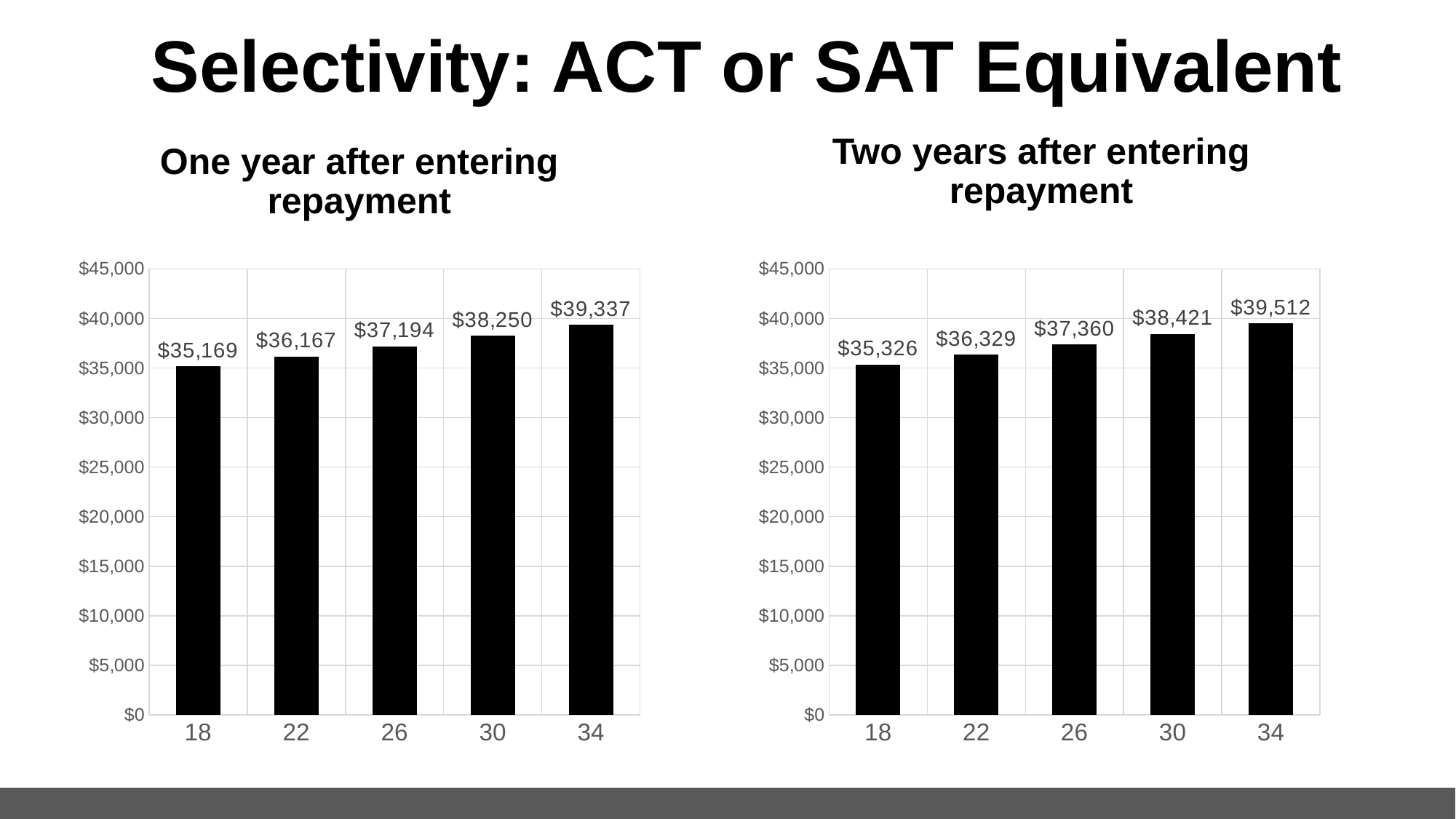
How many categories are shown in the 'One year after entering repayment' chart? 5 What is the title of the chart on the left side of the slide? One year after entering repayment In the 'One year after entering repayment' chart, what is the difference between the values for 34 and 18? $4,168 In the 'Two years after entering repayment' chart, which category has the lowest value? 18 What kind of chart is the 'Two years after entering repayment' chart? bar chart In the 'One year after entering repayment' chart, what is the value for 18? $35,169 In the 'Two years after entering repayment' chart, what is the value for 26? $37,360 In the 'Two years after entering repayment' chart, which is larger: the value for 22 or the value for 30? 30 In the 'Two years after entering repayment' chart, do the values rise or fall as the categories go from 18 to 34? rise In the 'Two years after entering repayment' chart, what is the difference between the values for 30 and 22? $2,092 In the 'One year after entering repayment' chart, which category has the highest value? 34 In the 'One year after entering repayment' chart, is the value for 26 greater or less than $40,000? less